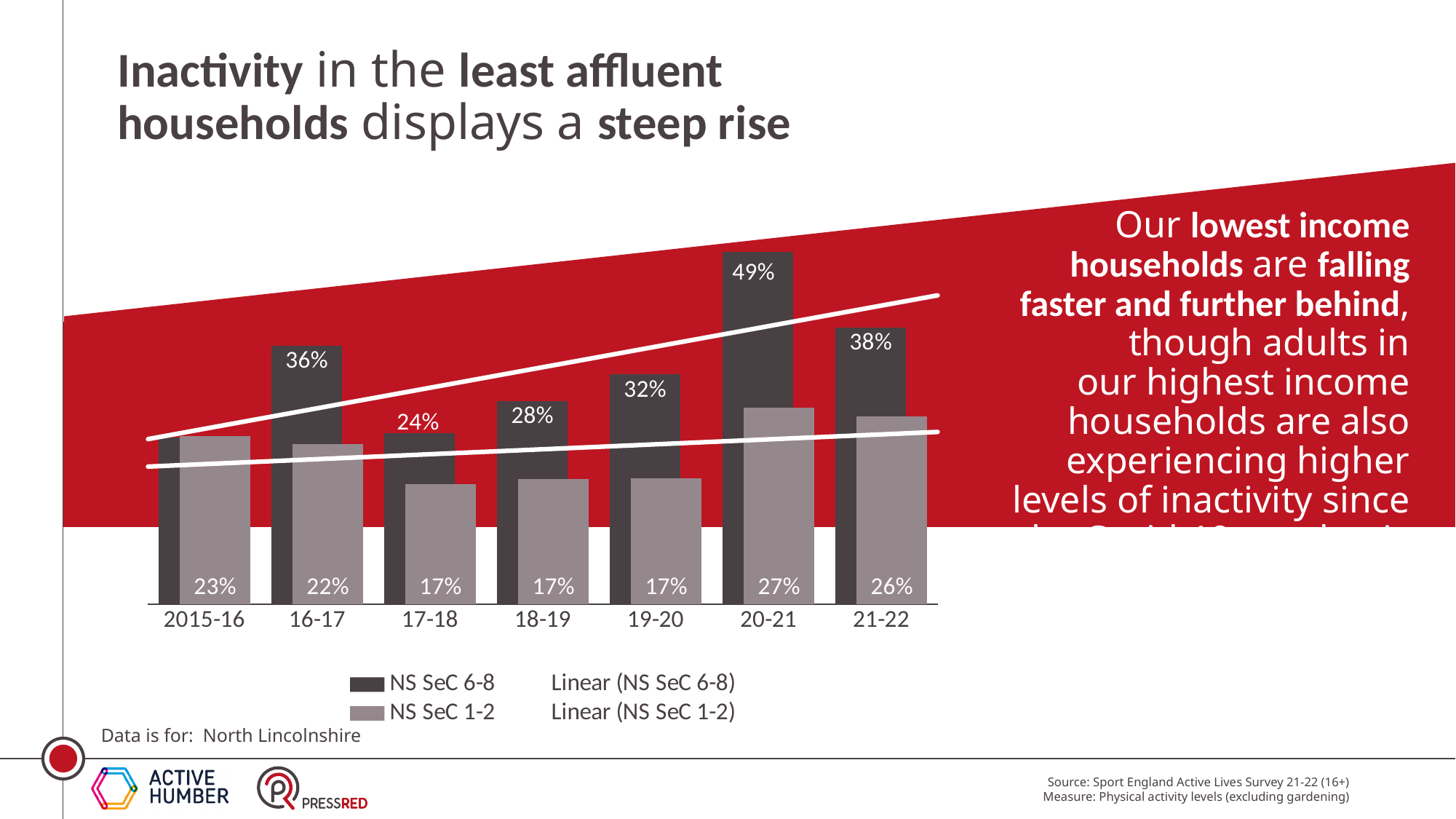
In 16-17, which series has the larger value, NS SeC 6-8 or NS SeC 1-2? NS SeC 6-8 What is the value for NS SeC 1-2 in 2015-16? 23% What is the value for NS SeC 1-2 in 17-18? 17% In which year is the NS SeC 1-2 value highest? 20-21 What is the difference between the NS SeC 6-8 and NS SeC 1-2 values in 20-21? 22 percentage points Does the linear trend line for NS SeC 6-8 rise or fall from 2015-16 to 21-22? Rise How many entries does the legend list? 4 How many years are shown on the x axis? 7 What kind of chart is shown on the slide? Bar chart What is the value for NS SeC 6-8 in 21-22? 38% What is the value for NS SeC 6-8 in 20-21? 49% In which year is the NS SeC 6-8 value highest? 20-21